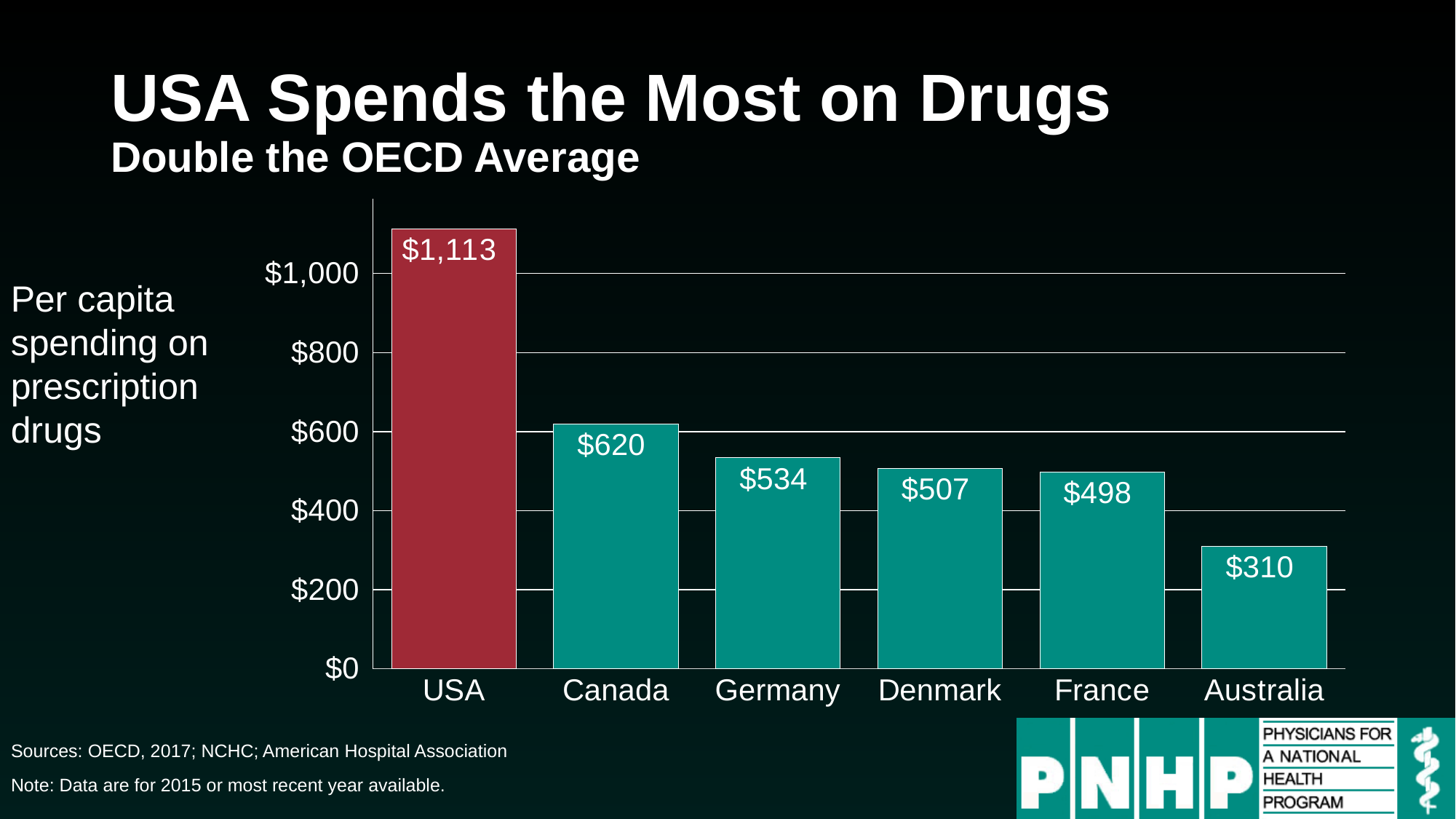
Which country has the highest per capita spending on prescription drugs? USA What is the per capita spending on prescription drugs for the USA? $1,113 What is the difference in per capita prescription drug spending between Denmark and France? $9 Which country spends more per capita on prescription drugs, Canada or Germany? Canada Is the value for France greater or less than $600? less What is the per capita spending on prescription drugs for Australia? $310 What is the difference in per capita prescription drug spending between the USA and Canada? $493 Which country has the lowest per capita spending on prescription drugs? Australia Which country's bar is shown in a different colour (red) from the others? USA How many countries are shown in the chart? 6 What is the per capita spending on prescription drugs for Germany? $534 What kind of chart is shown on the slide? Bar chart